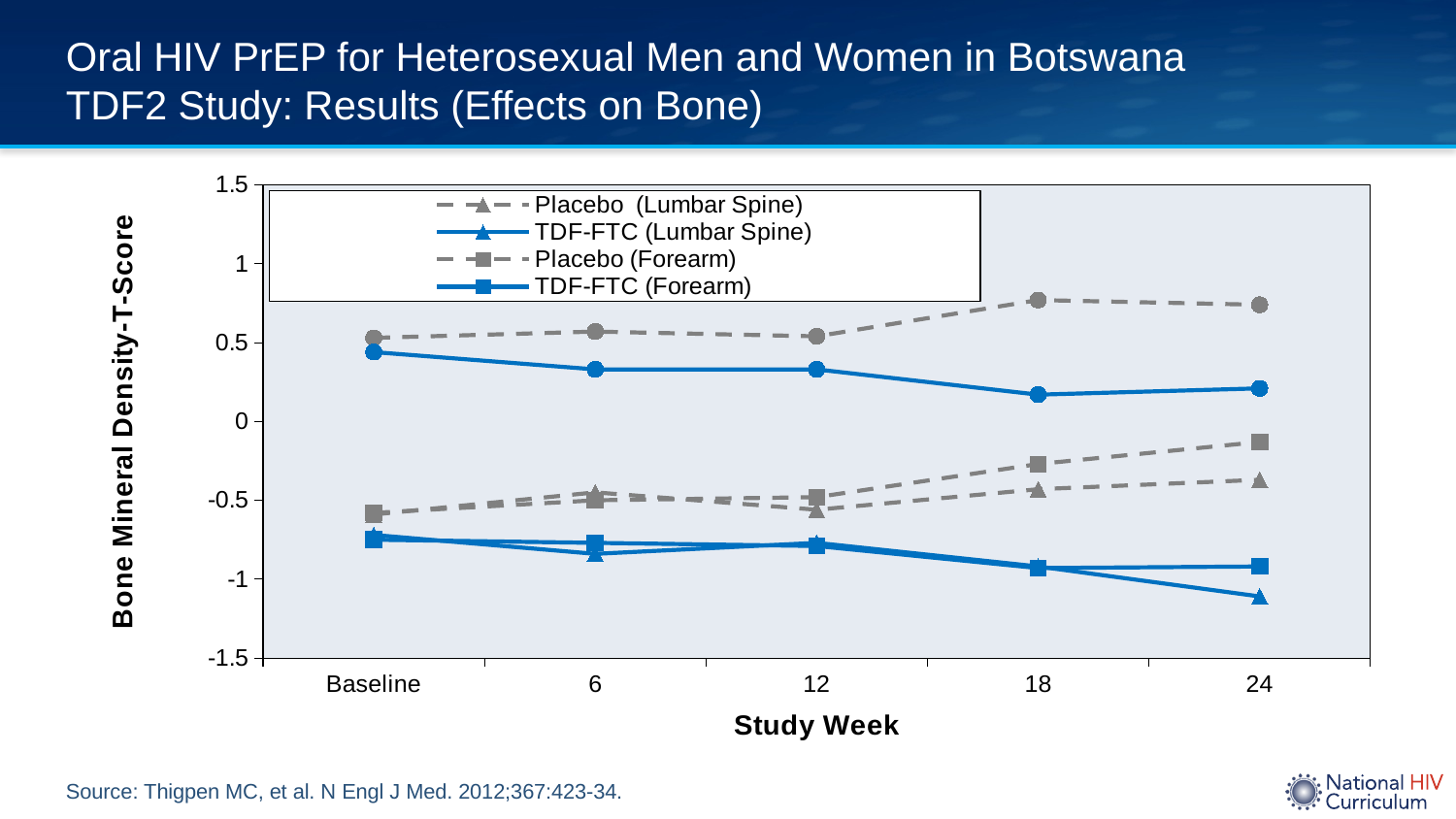
Is the value for Placebo (Lumbar Spine) at Baseline greater or less than -1? greater How many series does the legend list? 4 Is the value for Placebo (Forearm) at week 24 greater or less than -0.5? greater At week 24, which is larger: Placebo (Forearm) or TDF-FTC (Forearm)? Placebo (Forearm) Does the Placebo (Forearm) series rise or fall from Baseline to week 24? rise At week 24, which is larger: Placebo (Lumbar Spine) or TDF-FTC (Lumbar Spine)? Placebo (Lumbar Spine) Is the value for TDF-FTC (Forearm) at week 18 greater or less than -0.5? less How many study week points are shown along the x axis? 5 What is the label of the y axis? Bone Mineral Density-T-Score What kind of chart is shown on the slide? Line chart Does the TDF-FTC (Lumbar Spine) series rise or fall from Baseline to week 24? fall